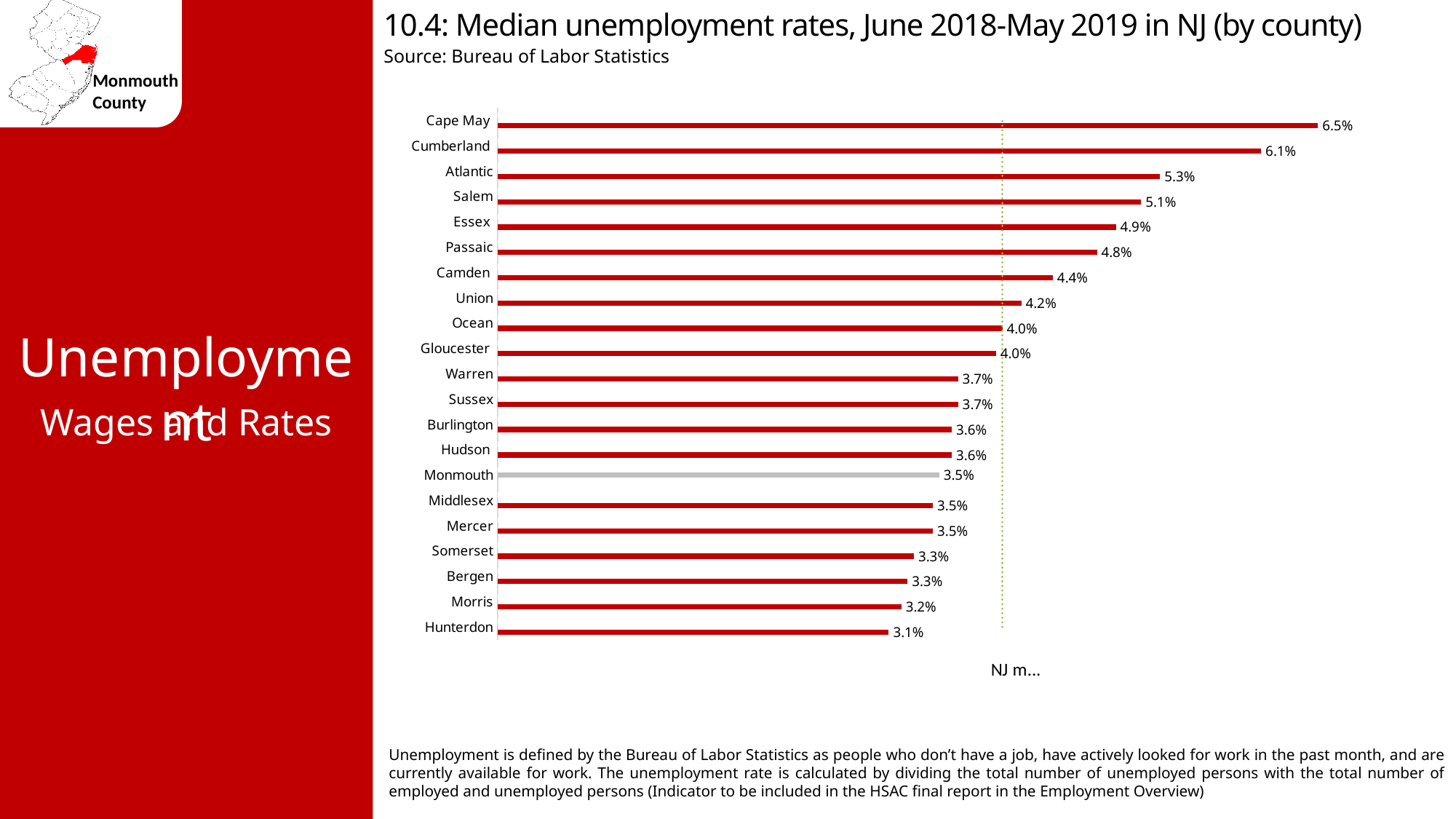
Which county's bar is shown in a different colour (grey) from the others? Monmouth How many counties are shown in the chart? 21 What is the median unemployment rate for Monmouth? 3.5% What type of chart is shown on the slide? Bar chart What is the difference between the median unemployment rates of Cape May and Hunterdon? 3.4% Which county has the lowest median unemployment rate? Hunterdon What is the difference between the median unemployment rates of Cumberland and Monmouth? 2.6% Which county has the highest median unemployment rate? Cape May Which county has a higher median unemployment rate, Essex or Camden? Essex What is the median unemployment rate for Cape May? 6.5% What is the median unemployment rate for Passaic? 4.8% Which county has a higher median unemployment rate, Morris or Union? Union